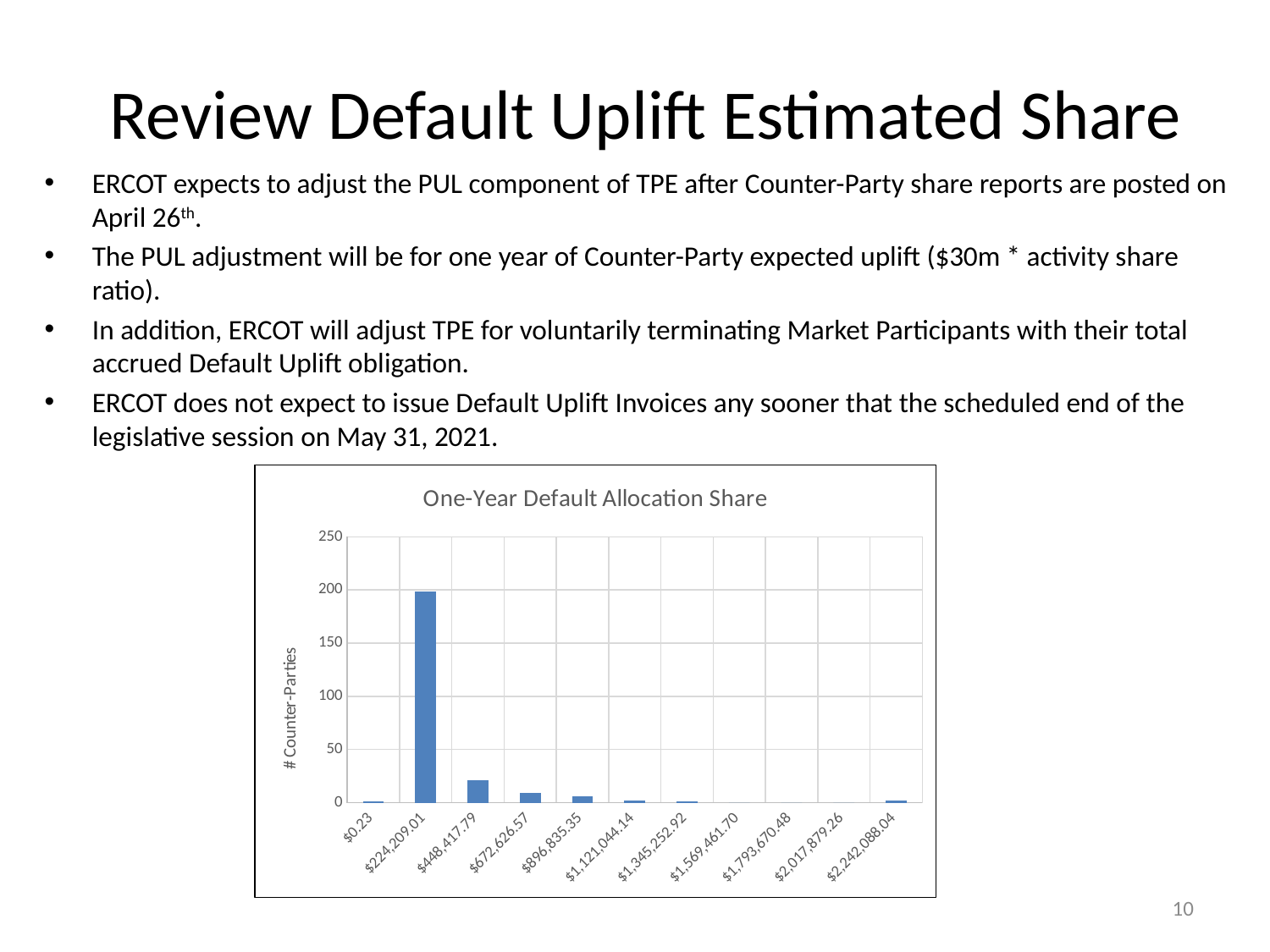
Which category has the highest number of Counter-Parties? $224,209.01 Which is larger, the value for $448,417.79 or the value for $896,835.35? $448,417.79 What is the title of the chart? One-Year Default Allocation Share Which is larger, the value for $224,209.01 or the value for $448,417.79? $224,209.01 Is the value for $672,626.57 greater or less than 50? less What is the label of the vertical axis of the chart? # Counter-Parties What is the highest tick value shown on the vertical axis? 250 How many categories are shown on the x axis of the chart? 11 What kind of chart is shown on the slide? bar chart Is the value for $224,209.01 greater or less than 150? greater Is the value for $448,417.79 greater or less than 50? less Do the values generally rise or fall along the x axis after the $224,209.01 category? fall